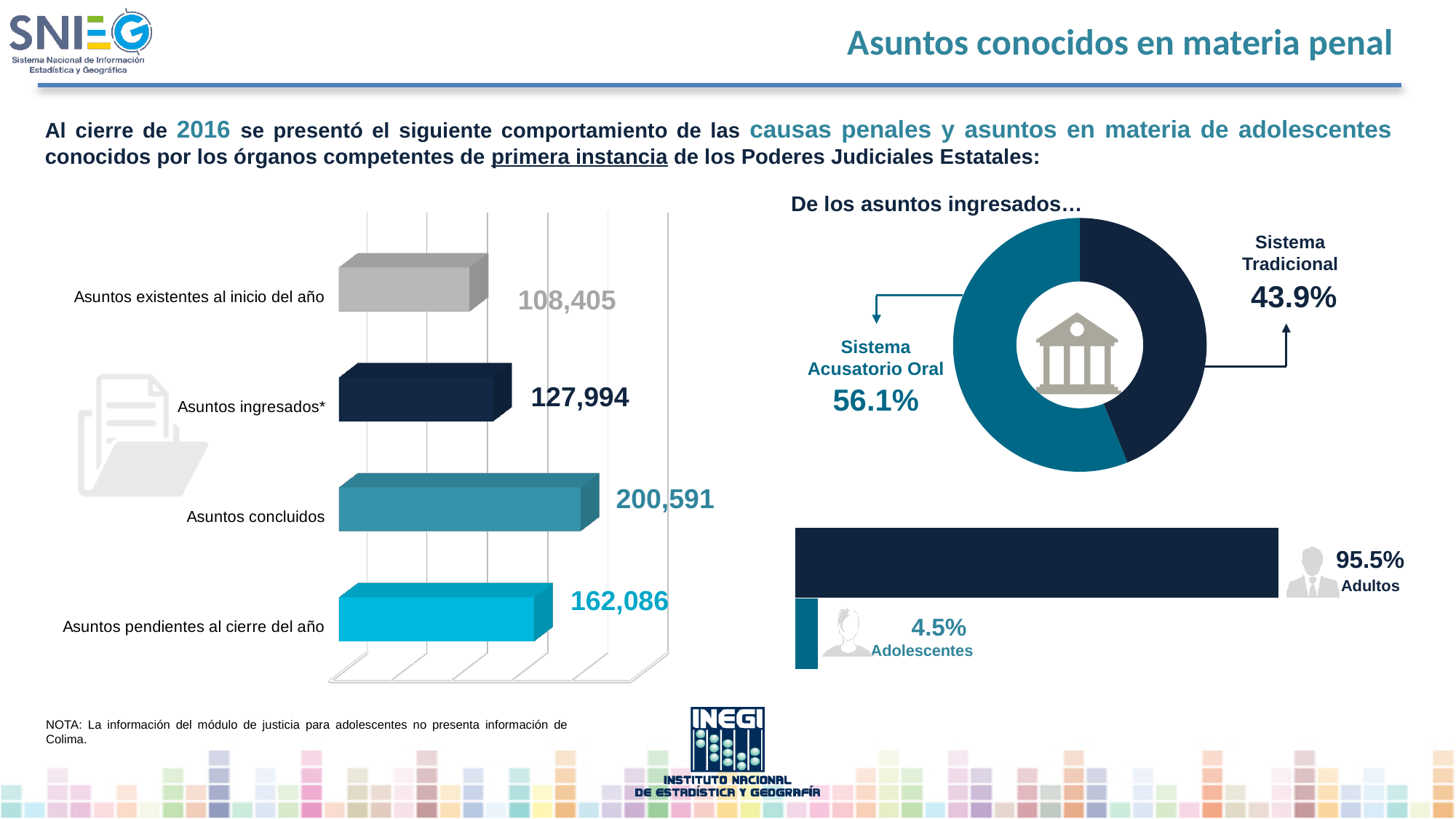
In the bar chart at the bottom right, what is the value for Adolescentes? 4.5% In the bar chart on the left, what is the difference between Asuntos concluidos and Asuntos ingresados*? 72,597 In the bar chart on the left, what is the value for Asuntos pendientes al cierre del año? 162,086 In the bar chart on the left, which is larger: Asuntos pendientes al cierre del año or Asuntos existentes al inicio del año? Asuntos pendientes al cierre del año In the bar chart on the left, what is the value for Asuntos ingresados*? 127,994 In the bar chart on the left, which category has the highest value? Asuntos concluidos In the donut chart titled 'De los asuntos ingresados…', what share corresponds to Sistema Acusatorio Oral? 56.1% In the bar chart on the left, which category has the lowest value? Asuntos existentes al inicio del año In the bar chart at the bottom right, what is the difference between Adultos and Adolescentes? 91.0% What kind of chart is the chart on the left of the slide? Bar chart In the donut chart titled 'De los asuntos ingresados…', which segment is larger: Sistema Tradicional or Sistema Acusatorio Oral? Sistema Acusatorio Oral How many categories does the bar chart on the left show? 4